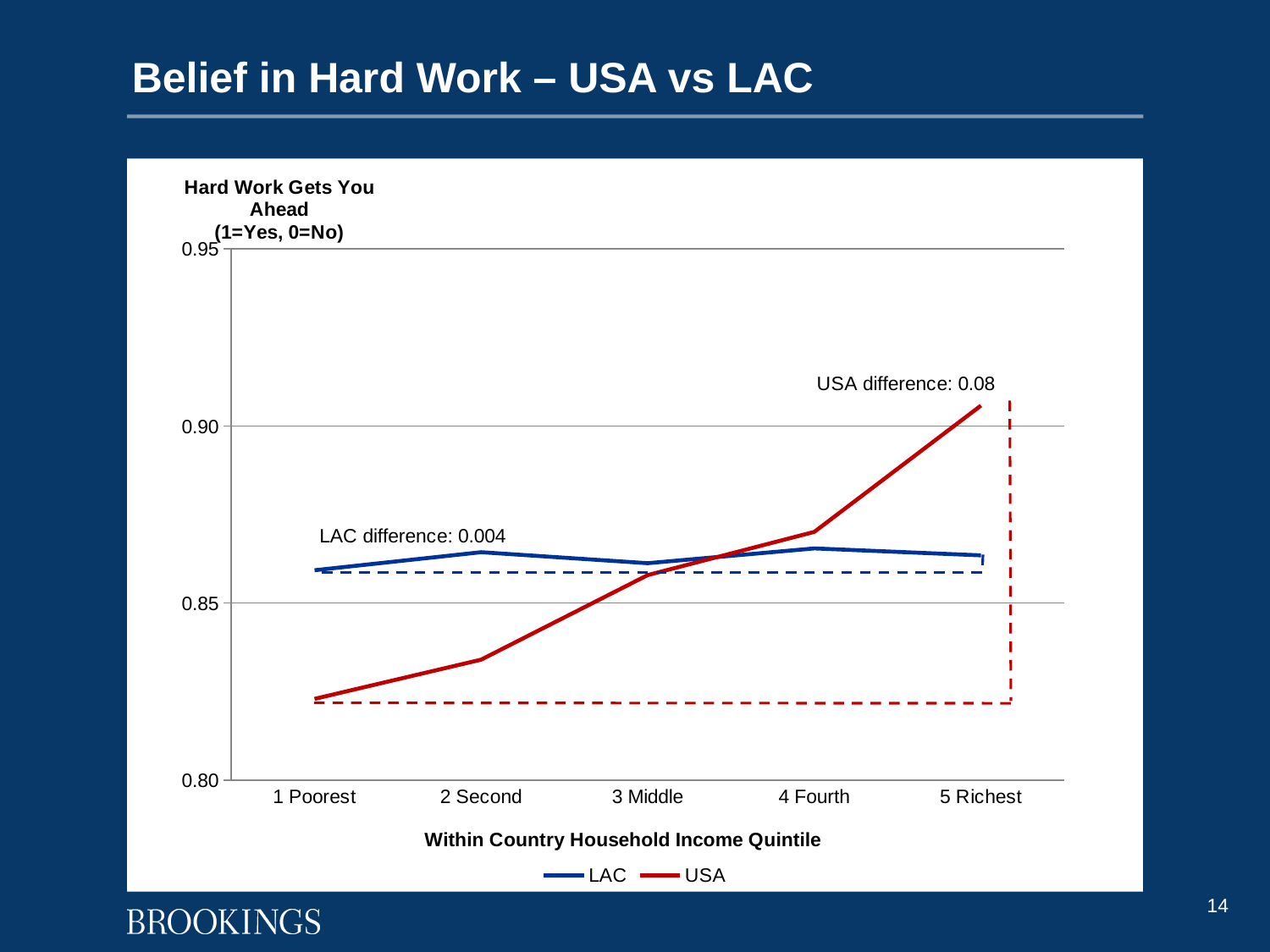
What kind of chart is shown on the slide? Line chart Is the USA value for 5 Richest greater or less than 0.90? greater According to the annotation, what is the LAC difference between the richest and poorest quintiles? 0.004 Do the USA values rise or fall as income quintile increases from 1 Poorest to 5 Richest? Rise Is the USA value for 1 Poorest greater or less than 0.85? less For which income quintile is the USA value highest? 5 Richest At the 2 Second quintile, which series has the larger value, LAC or USA? LAC According to the annotation, what is the USA difference between the richest and poorest quintiles? 0.08 How many income quintile categories are shown on the x axis? 5 For which income quintile is the USA value lowest? 1 Poorest What is the title of the x axis? Within Country Household Income Quintile How many series does the legend list? 2